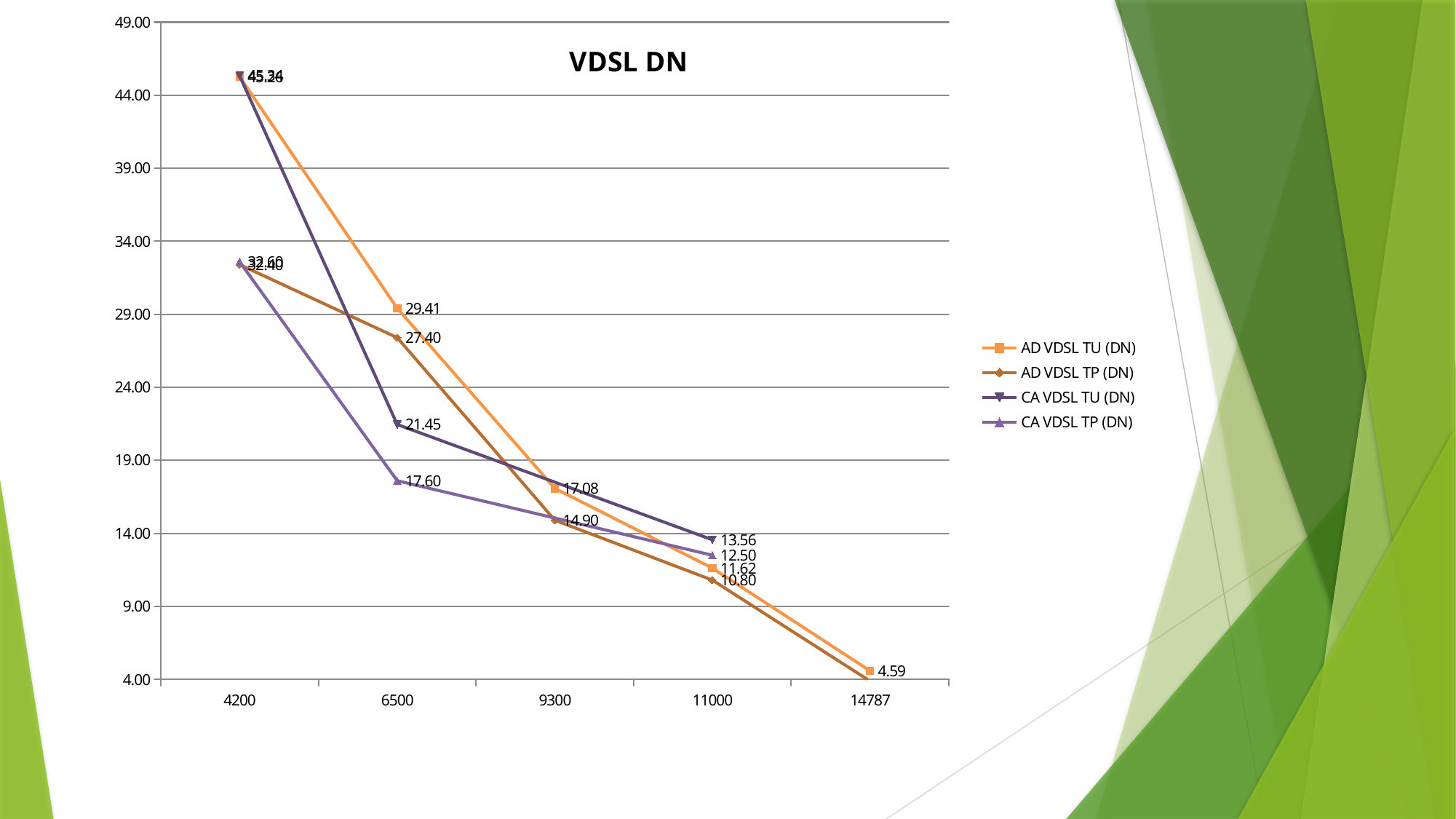
What is the value of CA VDSL TU (DN) at 6500? 21.45 Which series has the highest value at 6500? AD VDSL TU (DN) What type of chart is shown on the slide? line chart What is the value of AD VDSL TP (DN) at 6500? 27.40 What is the value of CA VDSL TP (DN) at 11000? 12.50 What is the difference between AD VDSL TU (DN) and AD VDSL TP (DN) at 6500? 2.01 How many series does the legend list? 4 Do the values of AD VDSL TU (DN) rise or fall along the x axis? fall How many categories are on the x axis? 5 What is the value of AD VDSL TU (DN) at 6500? 29.41 Which series has the lowest value at 11000? AD VDSL TP (DN) What is the value of AD VDSL TU (DN) at 14787? 4.59